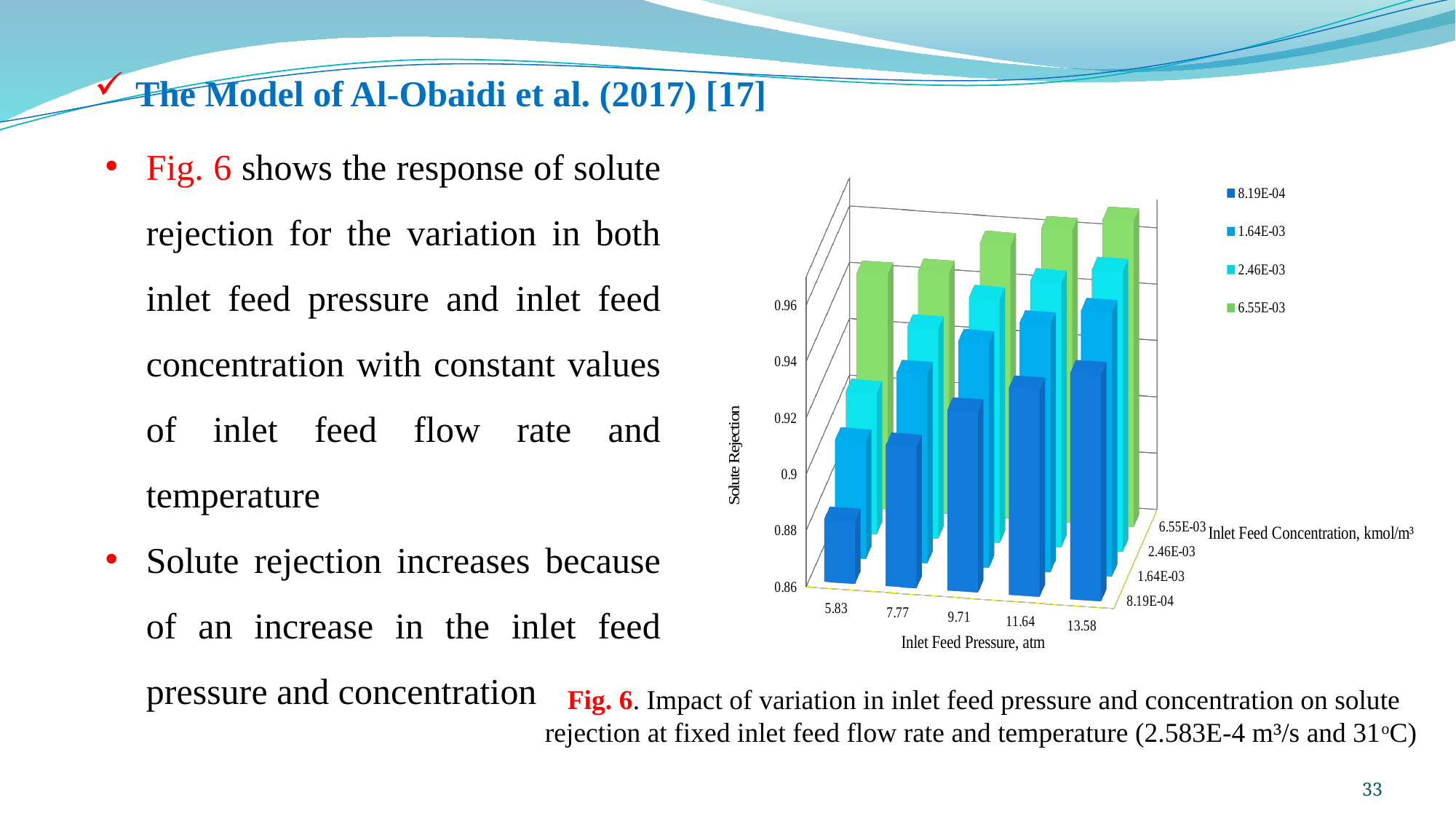
How many series does the legend list? 4 At 5.83 atm, which inlet feed concentration series has the lowest solute rejection? 8.19E-04 Is the solute rejection for the 6.55E-03 series at 13.58 atm greater or less than 0.9? greater What is the label of the vertical axis? Solute Rejection What kind of chart is shown on the slide? bar chart In the 8.19E-04 series, is solute rejection larger at 13.58 atm or at 5.83 atm? 13.58 How many inlet feed pressure values are plotted along the x axis? 5 For the 8.19E-04 series, at which inlet feed pressure is solute rejection highest? 13.58 Is the solute rejection for the 8.19E-04 series at 5.83 atm greater or less than 0.92? less Does solute rejection rise or fall as inlet feed pressure increases along the x axis? rise For the 8.19E-04 series, at which inlet feed pressure is solute rejection lowest? 5.83 What is the label of the horizontal axis? Inlet Feed Pressure, atm